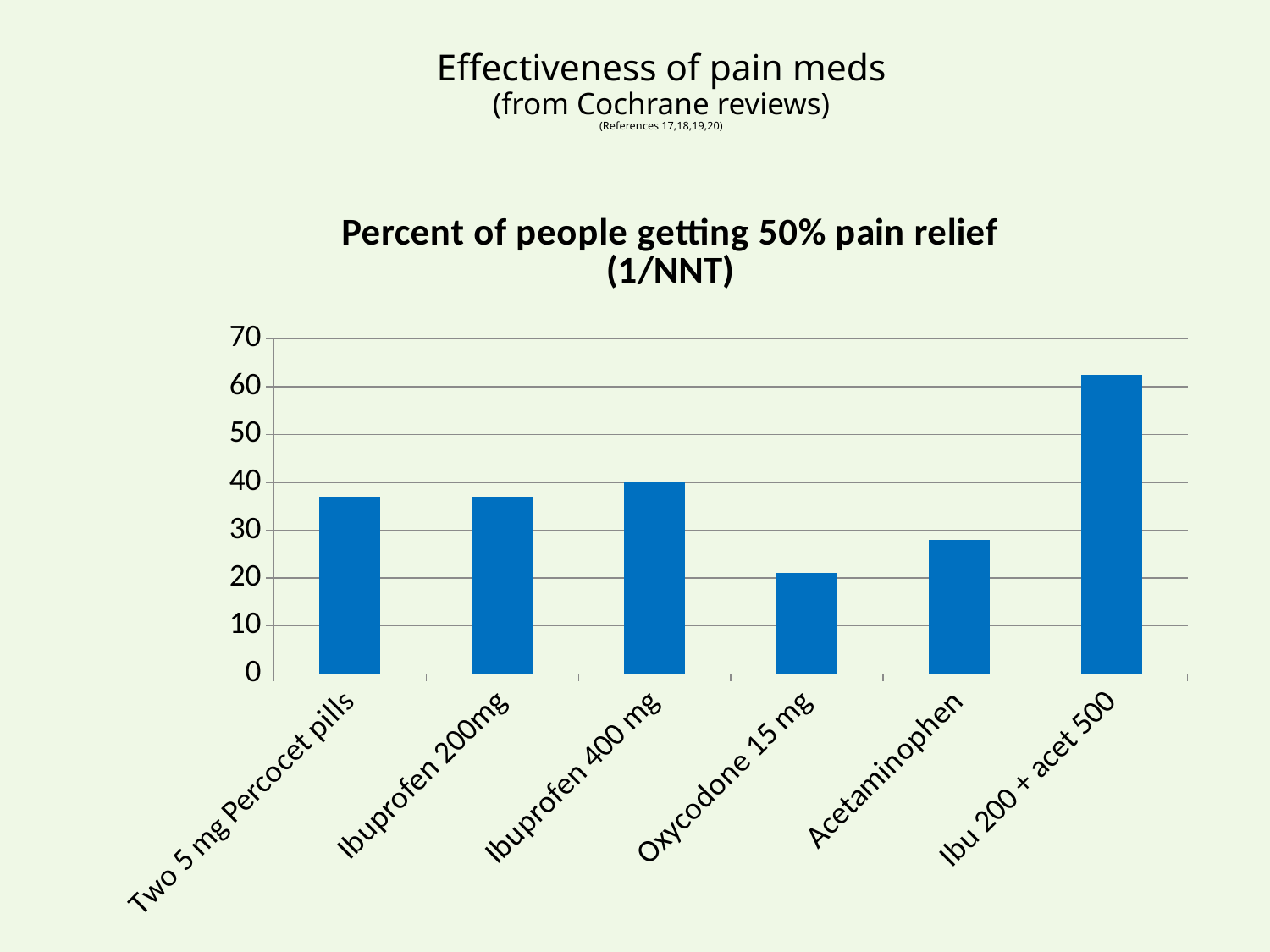
Which is larger, the value for Ibu 200 + acet 500 or the value for Ibuprofen 200mg? Ibu 200 + acet 500 Which category has the lowest percent of people getting 50% pain relief? Oxycodone 15 mg What kind of chart is shown on the slide? bar chart Is the value for Oxycodone 15 mg greater or less than 30? less How many pain medication categories are plotted in the chart? 6 Is the value for Ibu 200 + acet 500 greater or less than 60? greater Is the value for Acetaminophen greater or less than 20? greater What is the title of the chart? Percent of people getting 50% pain relief (1/NNT) Which category has the highest percent of people getting 50% pain relief? Ibu 200 + acet 500 What is the highest value shown on the vertical axis of the chart? 70 Which is larger, the value for Ibuprofen 400 mg or the value for Acetaminophen? Ibuprofen 400 mg